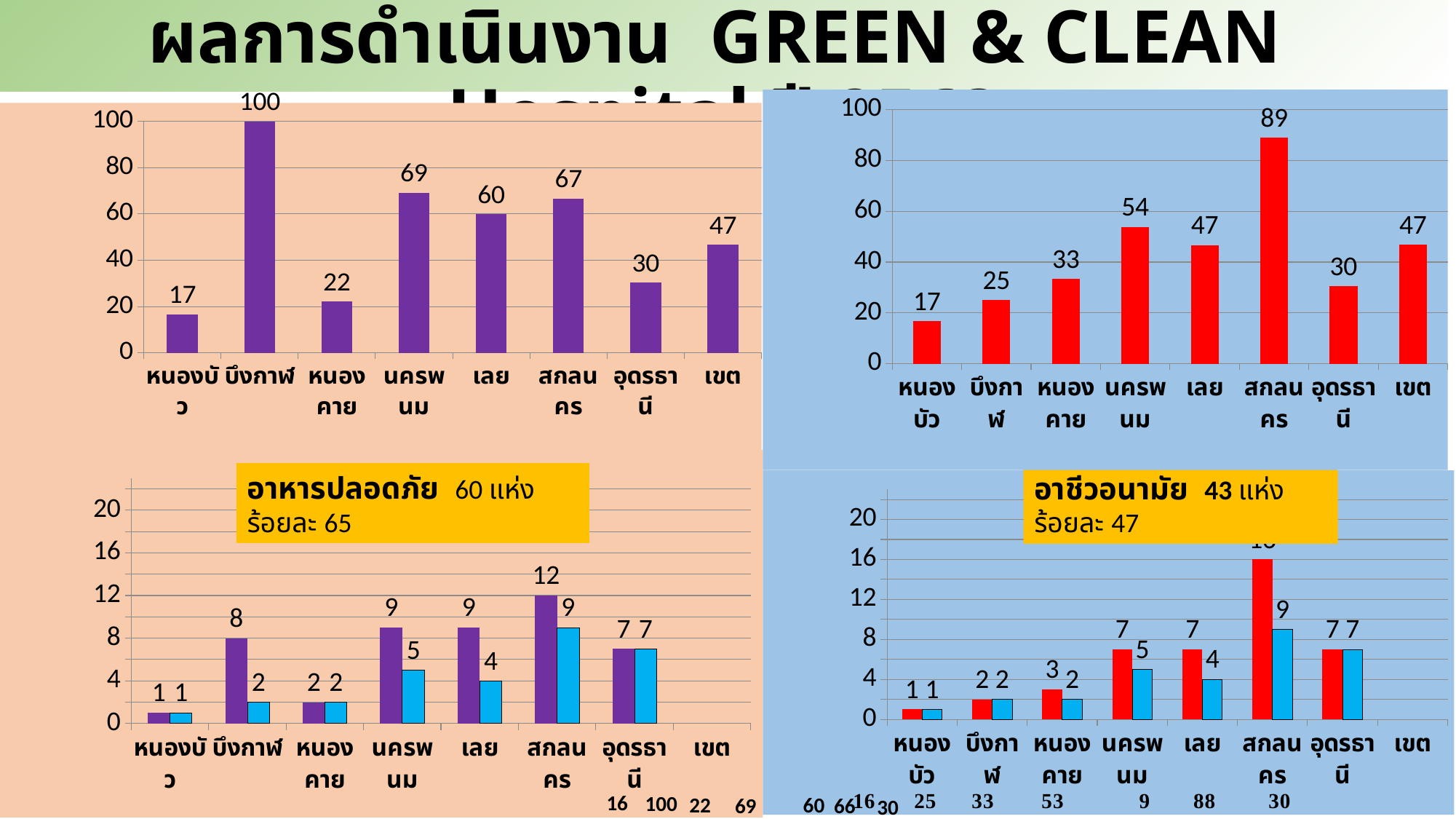
In the top-right chart, what is the value for นครพนม? 54 In the bottom-right chart, what is the value of the light blue bar for เลย? 4 In the bottom-left chart, what is the value of the purple bar for สกลนคร? 12 In the top-right chart, which is larger, the value for หนองคาย or the value for อุดรธานี? หนองคาย How many bars are plotted in the top-right chart? 8 In the bottom-right chart, what is the difference between the red bar and the light blue bar for สกลนคร? 7 In the top-left chart, what is the value for บึงกาฬ? 100 In the bottom-left chart, what is the total of the two bars for นครพนม? 14 What type of chart is the top-left chart? bar chart In the top-left chart, what is the difference between the values for นครพนม and เลย? 9 In the top-right chart, which category has the highest value? สกลนคร In the top-left chart, which category has the lowest value? หนองบัว